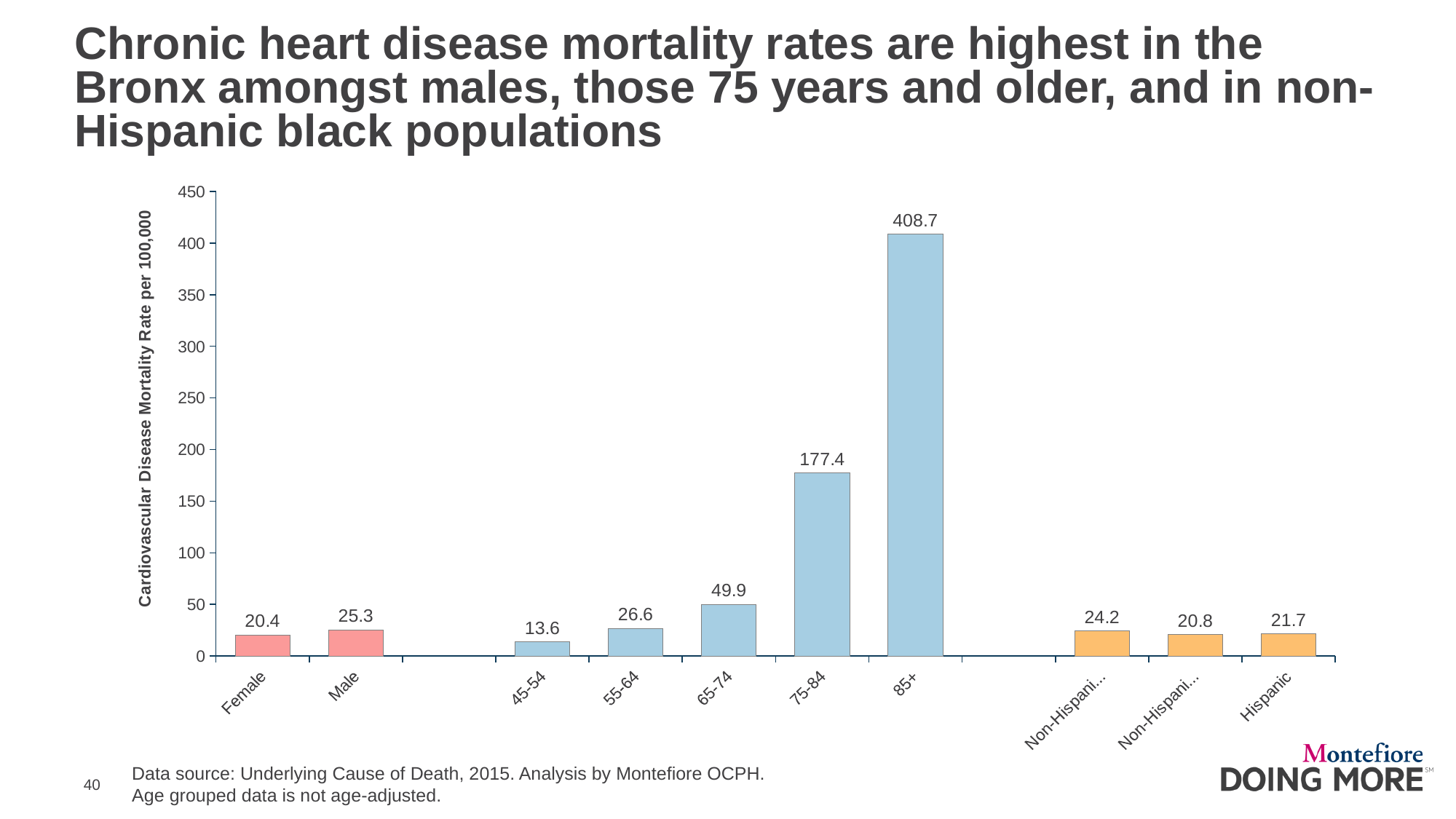
Which category has the lowest cardiovascular disease mortality rate? 45-54 Which has a higher mortality rate, the 55-64 age group or the 65-74 age group? 65-74 Which category has the highest cardiovascular disease mortality rate? 85+ What type of chart is shown on the slide? Bar chart What is the cardiovascular disease mortality rate for males? 25.3 How many bars are plotted on the chart? 10 What is the cardiovascular disease mortality rate for the 85+ age group? 408.7 What is the cardiovascular disease mortality rate for the 65-74 age group? 49.9 What is the difference between the mortality rates for males and females? 4.9 What is the cardiovascular disease mortality rate for Hispanic populations? 21.7 What is the difference between the mortality rates for the 85+ and 75-84 age groups? 231.3 Is the value for the 75-84 age group greater or less than 150? greater